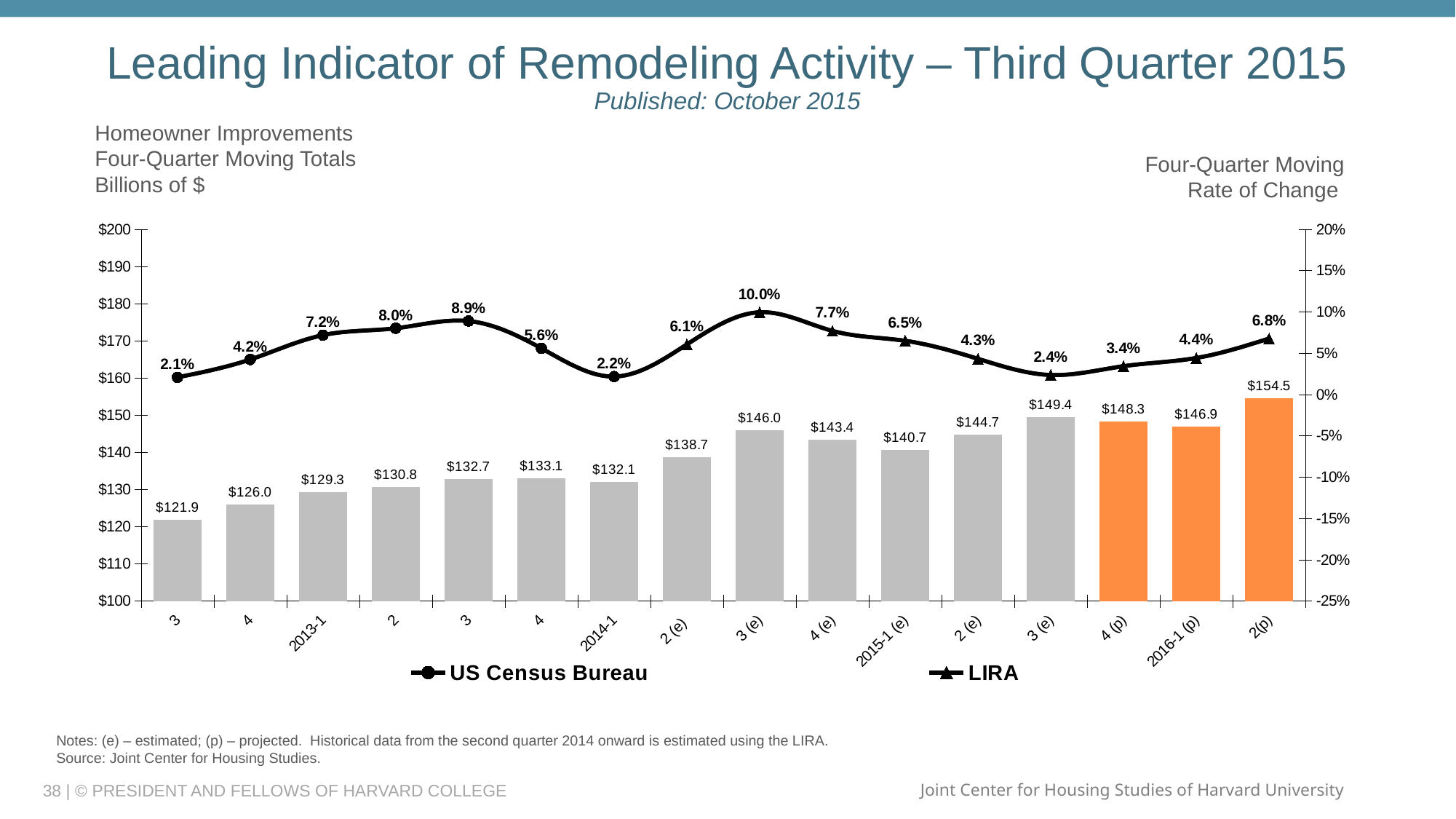
What is the four-quarter moving rate of change shown for 2015-1 (e)? 6.5% What is the highest four-quarter moving rate of change shown on the line? 10.0% Which has a larger four-quarter moving total, 2015-1 (e) or 2016-1 (p)? 2016-1 (p) What kind of chart is this? Combined bar and line chart What is the four-quarter moving total for 2016-1 (p)? $146.9 How many bars are plotted on the chart? 16 What is the four-quarter moving total for 2014-1? $132.1 What is the lowest four-quarter moving total shown on the bars? $121.9 What is the difference between the four-quarter moving totals for 2(p) and 4 (p)? $6.2 Which bar has the highest four-quarter moving total? 2(p) Does the rate of change rise or fall from 2013-1 through the 2013 quarter 3 point? Rise How many series does the legend list? 2